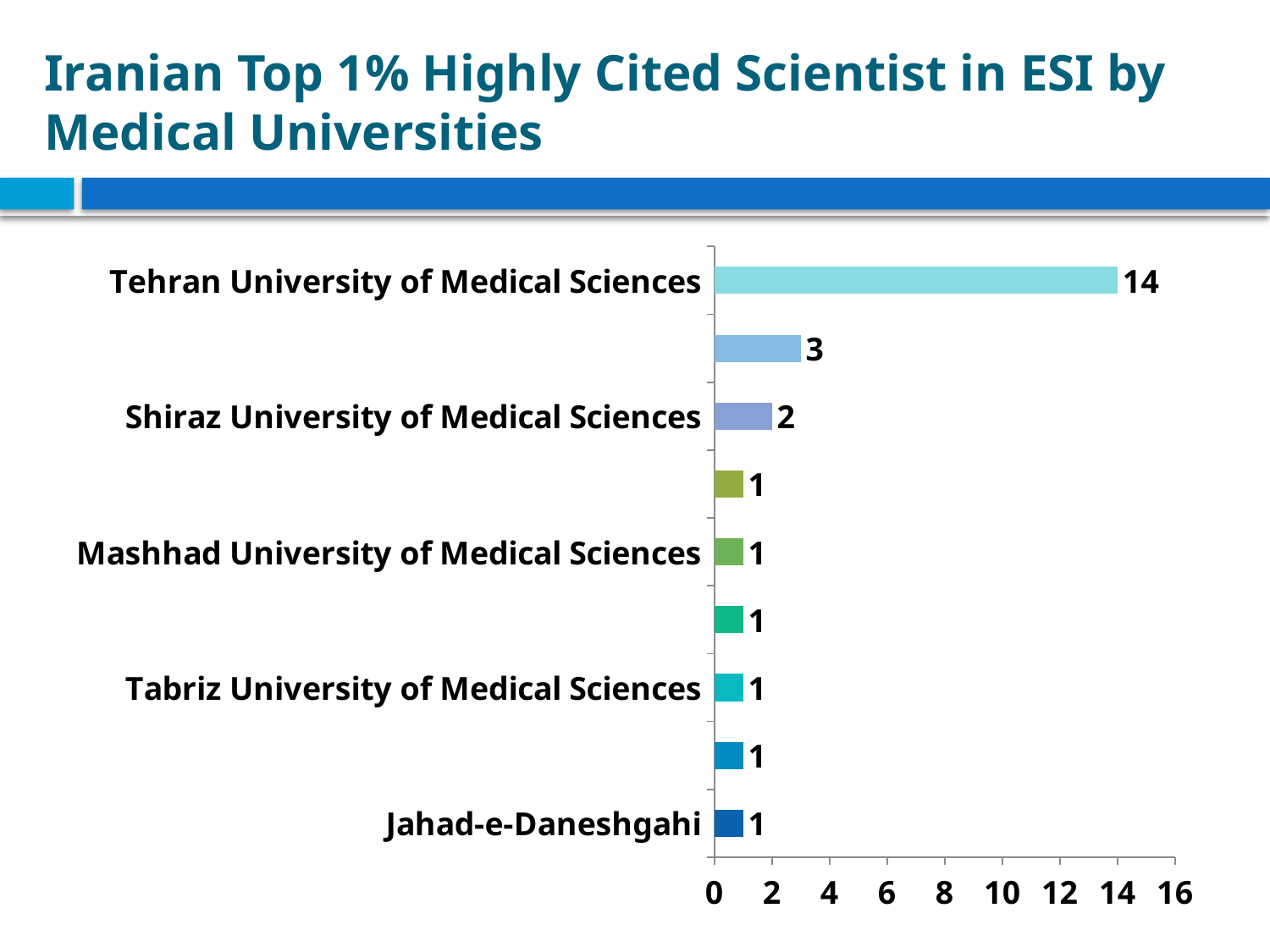
Is the value for Tehran University of Medical Sciences greater or less than 10? greater What kind of chart is shown on the slide? bar chart What is the value for Mashhad University of Medical Sciences? 1 What is the value for Shiraz University of Medical Sciences? 2 How many bars are plotted in the chart? 9 What is the title of the slide? Iranian Top 1% Highly Cited Scientist in ESI by Medical Universities What is the difference between the values for Tehran University of Medical Sciences and Shiraz University of Medical Sciences? 12 Which university has the highest value in the chart? Tehran University of Medical Sciences Which is larger, the value for Tehran University of Medical Sciences or the value for Shiraz University of Medical Sciences? Tehran University of Medical Sciences What is the value for Jahad-e-Daneshgahi? 1 What is the value for Tabriz University of Medical Sciences? 1 What is the value for Tehran University of Medical Sciences? 14